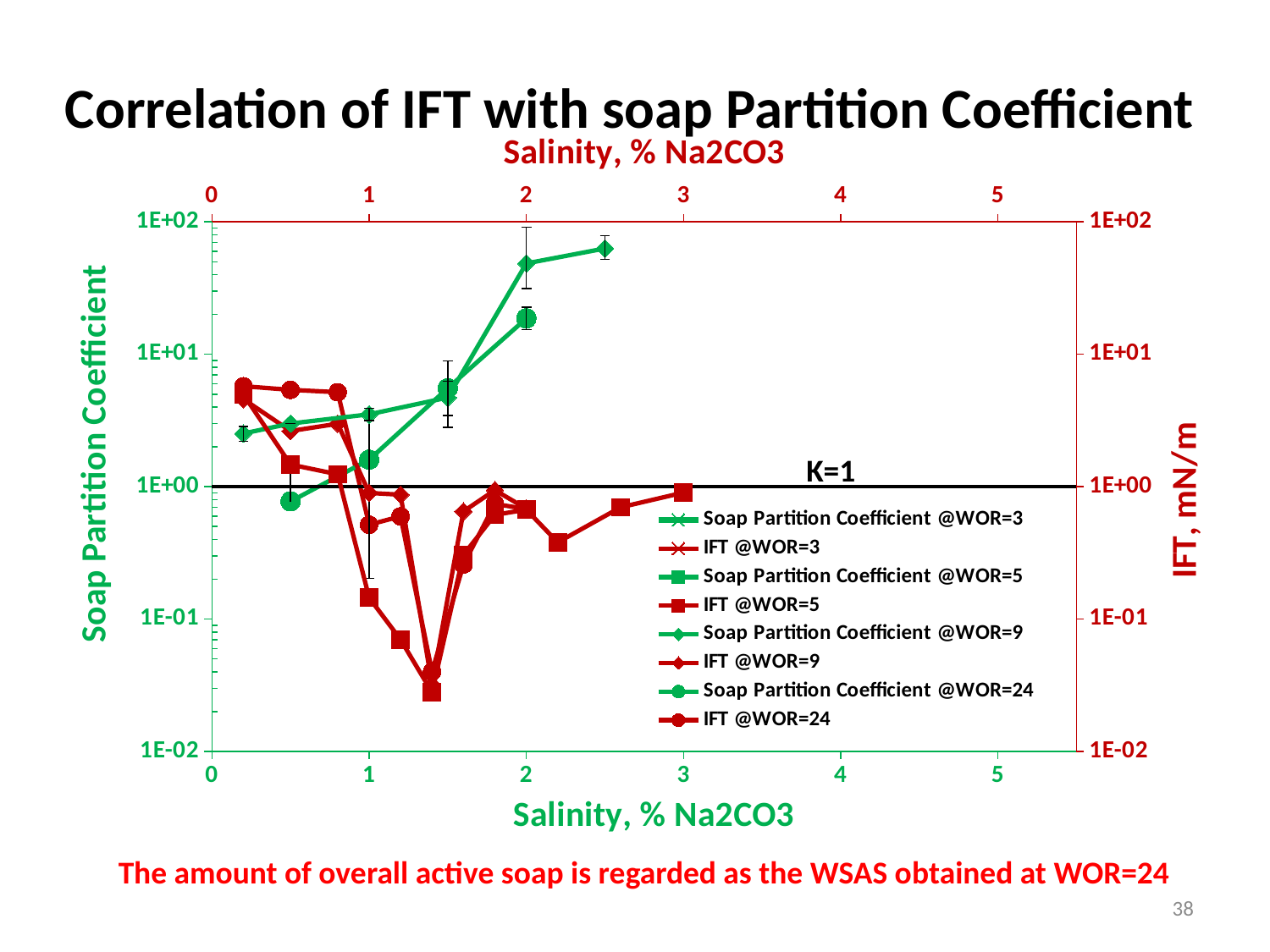
Is the value of IFT @WOR=24 at salinity 0.5 greater or less than 1E+00? greater How many series in the legend are Soap Partition Coefficient series? 4 Is the value of Soap Partition Coefficient @WOR=24 at salinity 0.5 greater or less than 1E+00? less Does Soap Partition Coefficient @WOR=9 rise or fall as salinity increases from 0.2 to 2.5? rise Does IFT @WOR=5 rise or fall as salinity increases from 0.2 to 1.4? fall What is the title of the chart? Correlation of IFT with soap Partition Coefficient How many series does the legend list? 8 What kind of chart is shown on the slide? Line chart At salinity 2, which is larger: Soap Partition Coefficient @WOR=9 or Soap Partition Coefficient @WOR=24? Soap Partition Coefficient @WOR=9 What is the label of the right-hand vertical axis? IFT, mN/m Is the lowest value of IFT @WOR=5 greater or less than 1E-01? less